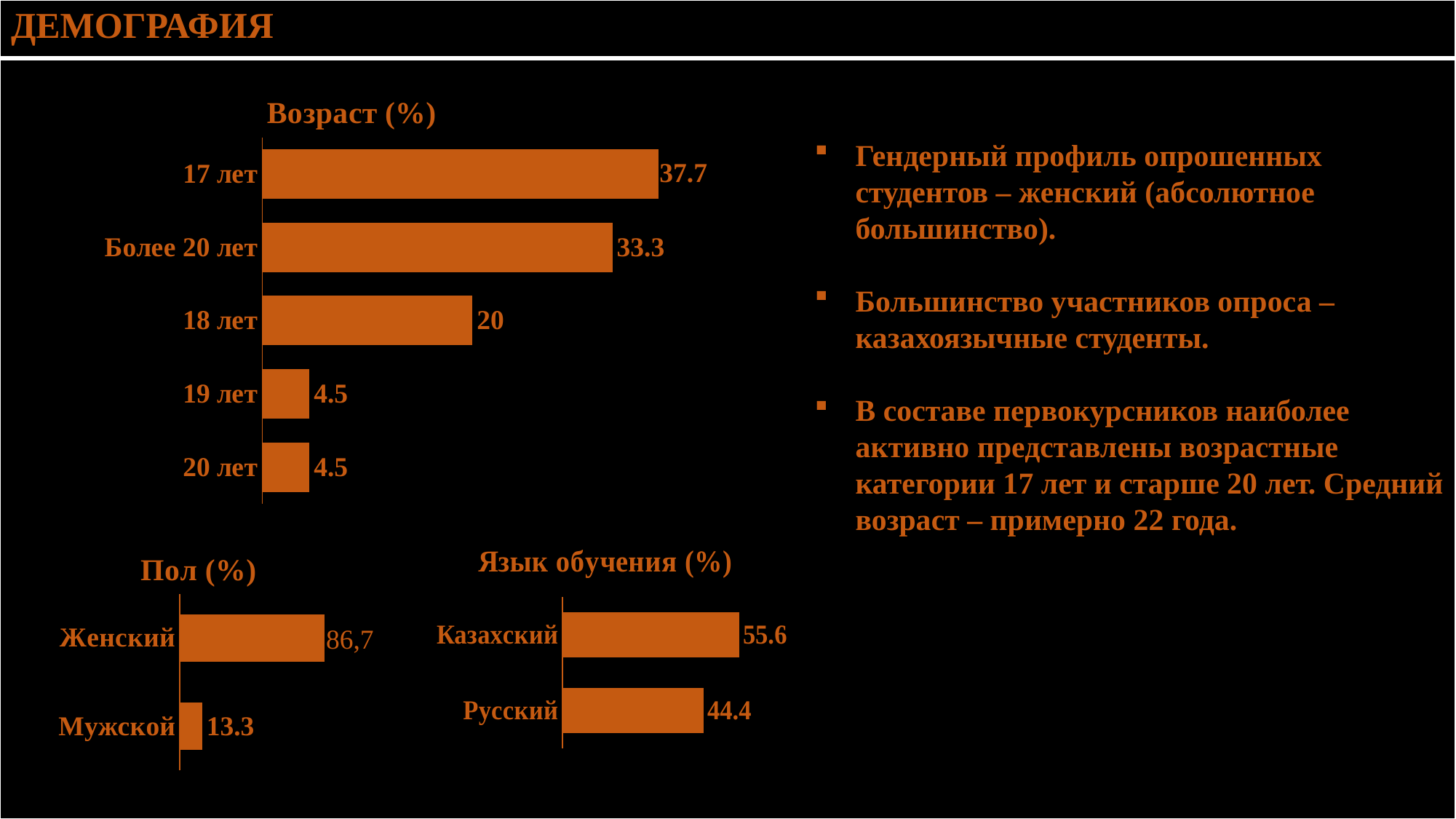
How many charts are shown on the slide? 3 In the 'Возраст (%)' chart, which is larger: the value for 'Более 20 лет' or the value for '18 лет'? Более 20 лет In the 'Возраст (%)' chart, how many categories are shown? 5 In the 'Возраст (%)' chart, what is the difference between the values for '17 лет' and '18 лет'? 17.7 In the 'Возраст (%)' chart, what is the value for 'Более 20 лет'? 33.3 In the 'Возраст (%)' chart, which category has the highest value? 17 лет In the 'Возраст (%)' chart, what is the value for '17 лет'? 37.7 In the 'Пол (%)' chart, what is the value for 'Женский'? 86,7 In the 'Пол (%)' chart, what is the value for 'Мужской'? 13.3 What type of chart is the 'Язык обучения (%)' chart? Bar chart In the 'Язык обучения (%)' chart, what is the value for 'Казахский'? 55.6 In the 'Язык обучения (%)' chart, what is the difference between the values for 'Казахский' and 'Русский'? 11.2